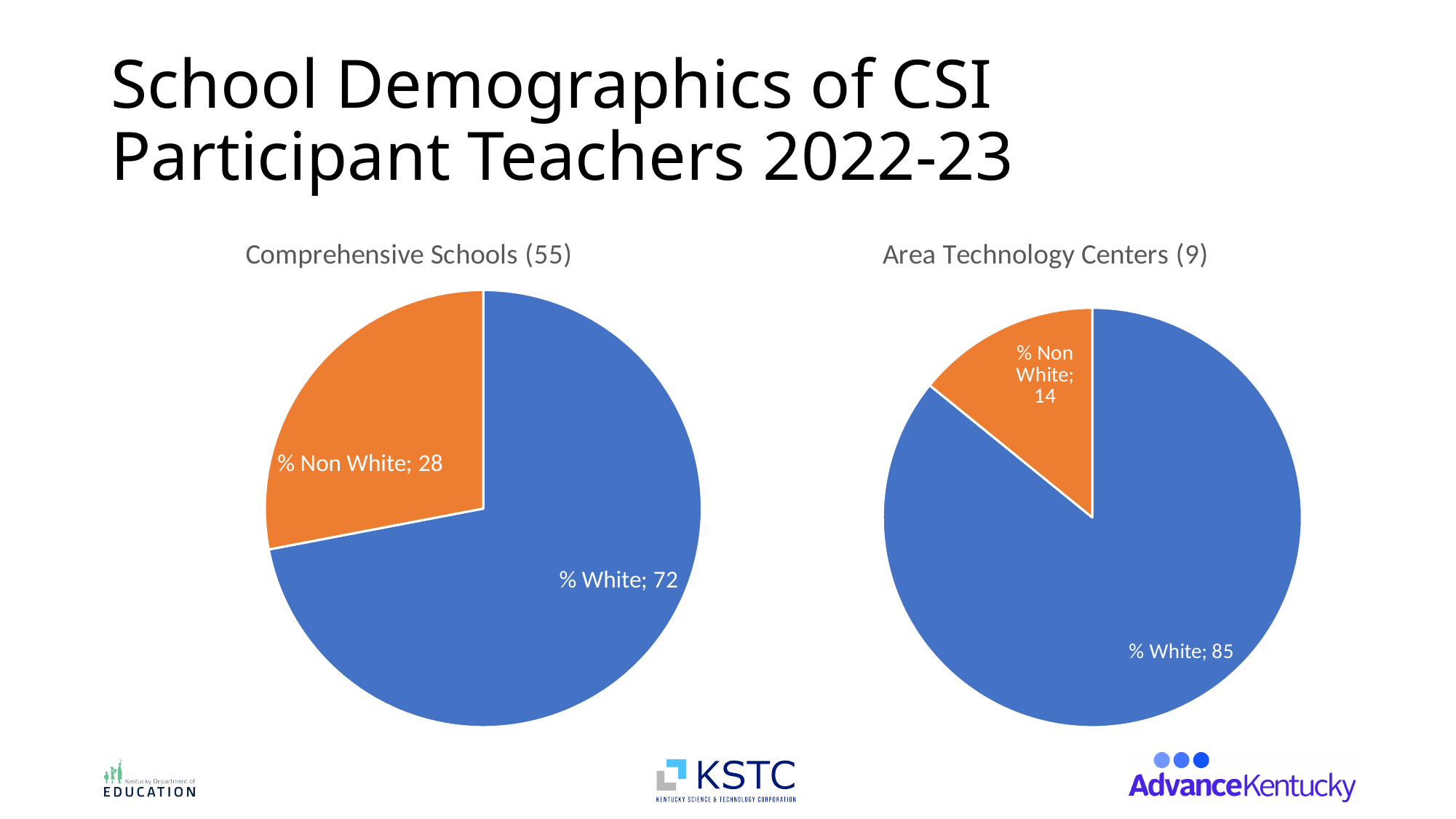
In the Comprehensive Schools (55) chart, what is the value for % Non White? 28 In the Area Technology Centers (9) chart, what is the value for % White? 85 How many slices does the Area Technology Centers (9) chart have? 2 In the Comprehensive Schools (55) chart, what is the value for % White? 72 In the Area Technology Centers (9) chart, what is the value for % Non White? 14 In the Comprehensive Schools (55) chart, which slice is the largest? % White In the Comprehensive Schools (55) chart, what is the difference between % White and % Non White? 44 What colour is the % Non White slice in the Comprehensive Schools (55) chart? Orange Which chart has the larger % Non White value, Comprehensive Schools (55) or Area Technology Centers (9)? Comprehensive Schools (55) In the Area Technology Centers (9) chart, what is the difference between % White and % Non White? 71 In the Area Technology Centers (9) chart, which slice is the smallest? % Non White What kind of chart is the Comprehensive Schools (55) chart? Pie chart